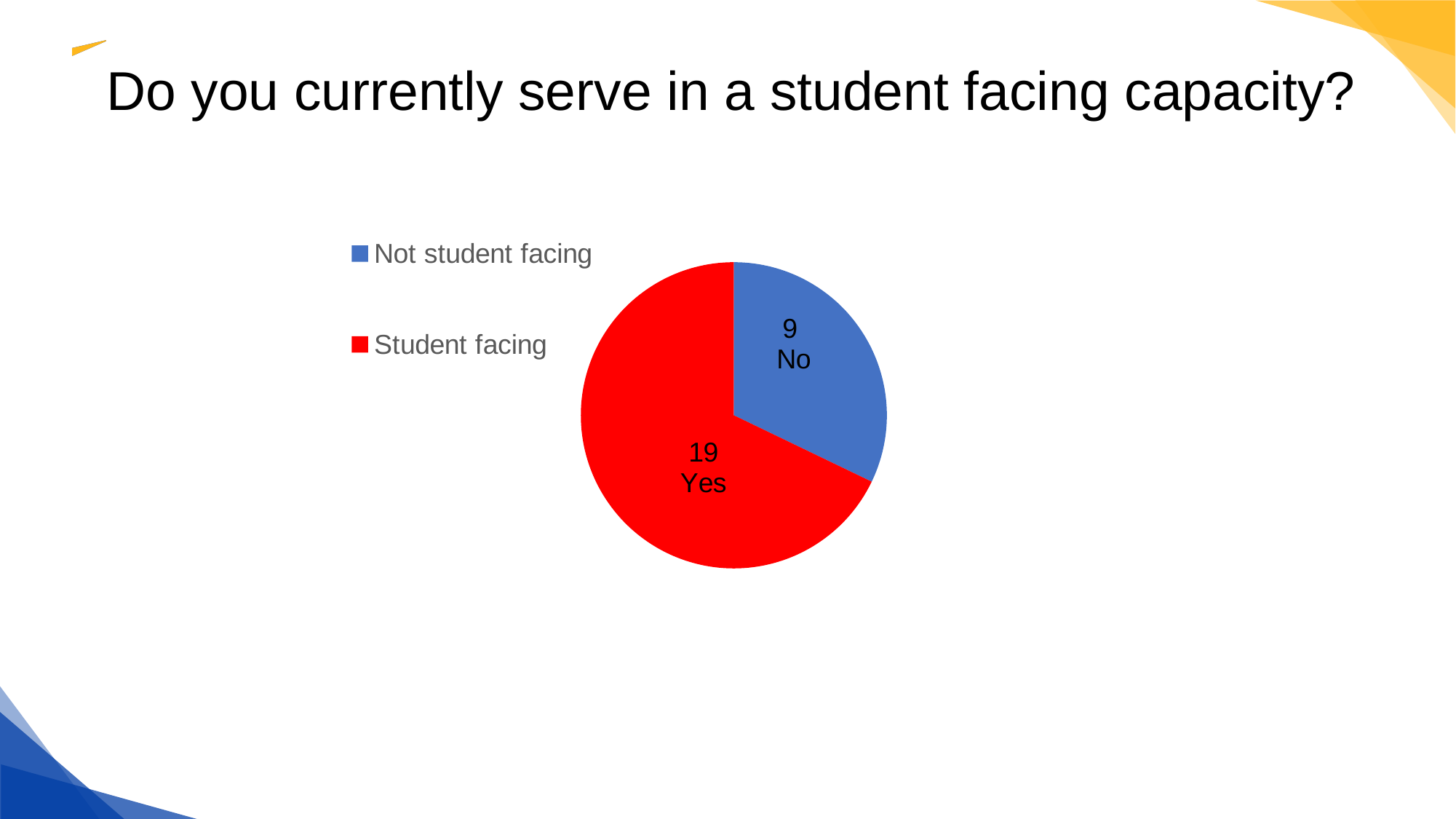
What is the value for the Student facing slice? 19 What is the total of all slices in the pie chart? 28 Which is larger, the Student facing slice or the Not student facing slice? Student facing Which category has the largest slice? Student facing Which category has the smallest slice? Not student facing What is the value for the Not student facing slice? 9 How many slices does the pie chart have? 2 What text label accompanies the value 9 on the pie chart? No What is the difference between the Student facing and Not student facing values? 10 What colour is the Not student facing slice? blue What type of chart is shown on the slide? pie chart What colour is the Student facing slice? red